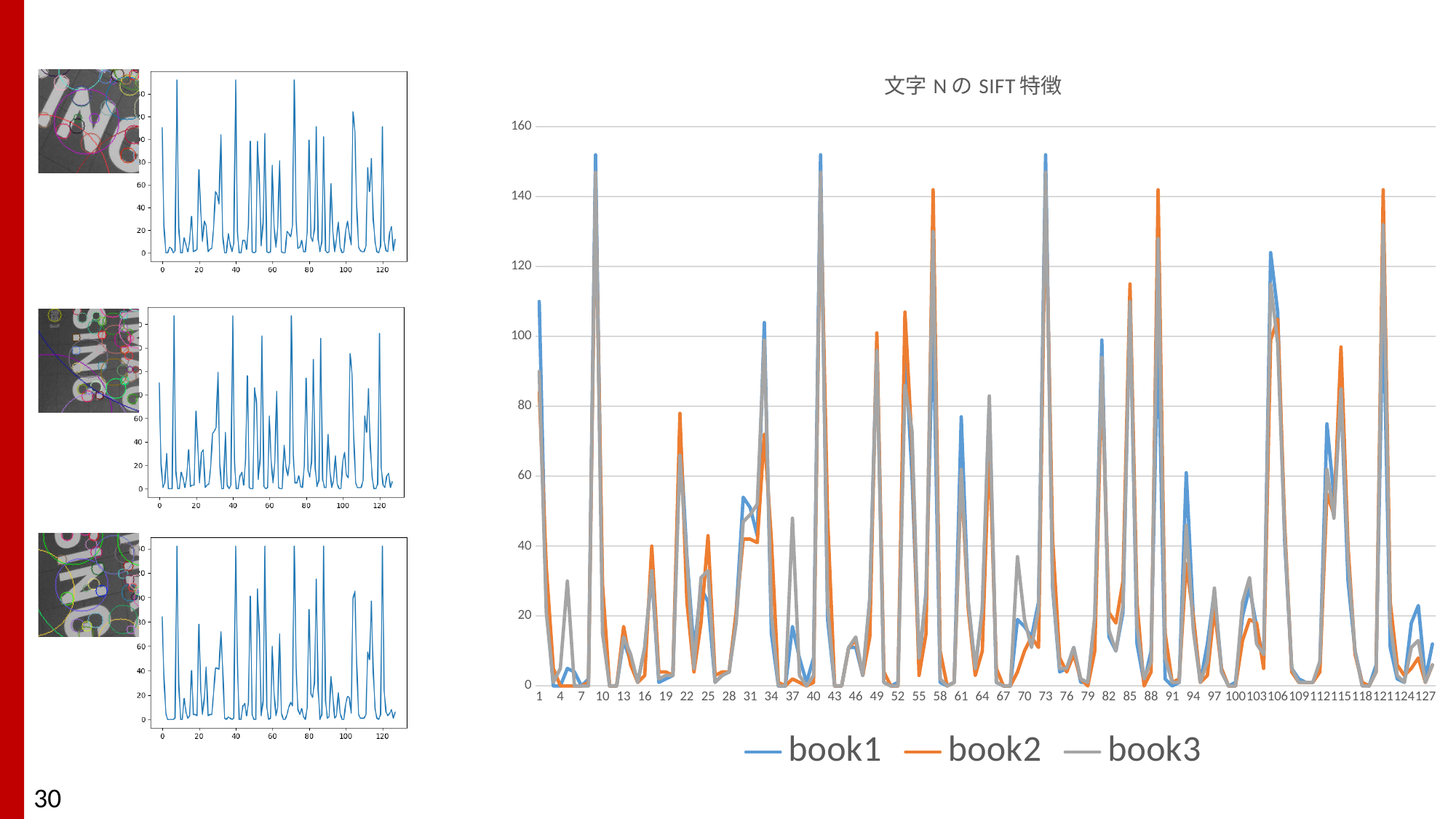
In the chart titled 文字 N の SIFT 特徴, is the value of book1 at x = 1 greater or less than 100? greater In the chart titled 文字 N の SIFT 特徴, is the value of book1 at x = 61 greater or less than 60? greater In the chart titled 文字 N の SIFT 特徴, what are the names of the series in the legend? book1, book2, book3 In the chart titled 文字 N の SIFT 特徴, is the value of book2 at x = 4 greater or less than 20? less How many series does the legend of the chart titled 文字 N の SIFT 特徴 list? 3 In the chart titled 文字 N の SIFT 特徴, at x = 1, which series has the larger value, book1 or book3? book1 In the chart titled 文字 N の SIFT 特徴, what is the highest value shown on the vertical axis? 160 What kind of chart is the chart titled 文字 N の SIFT 特徴? line chart